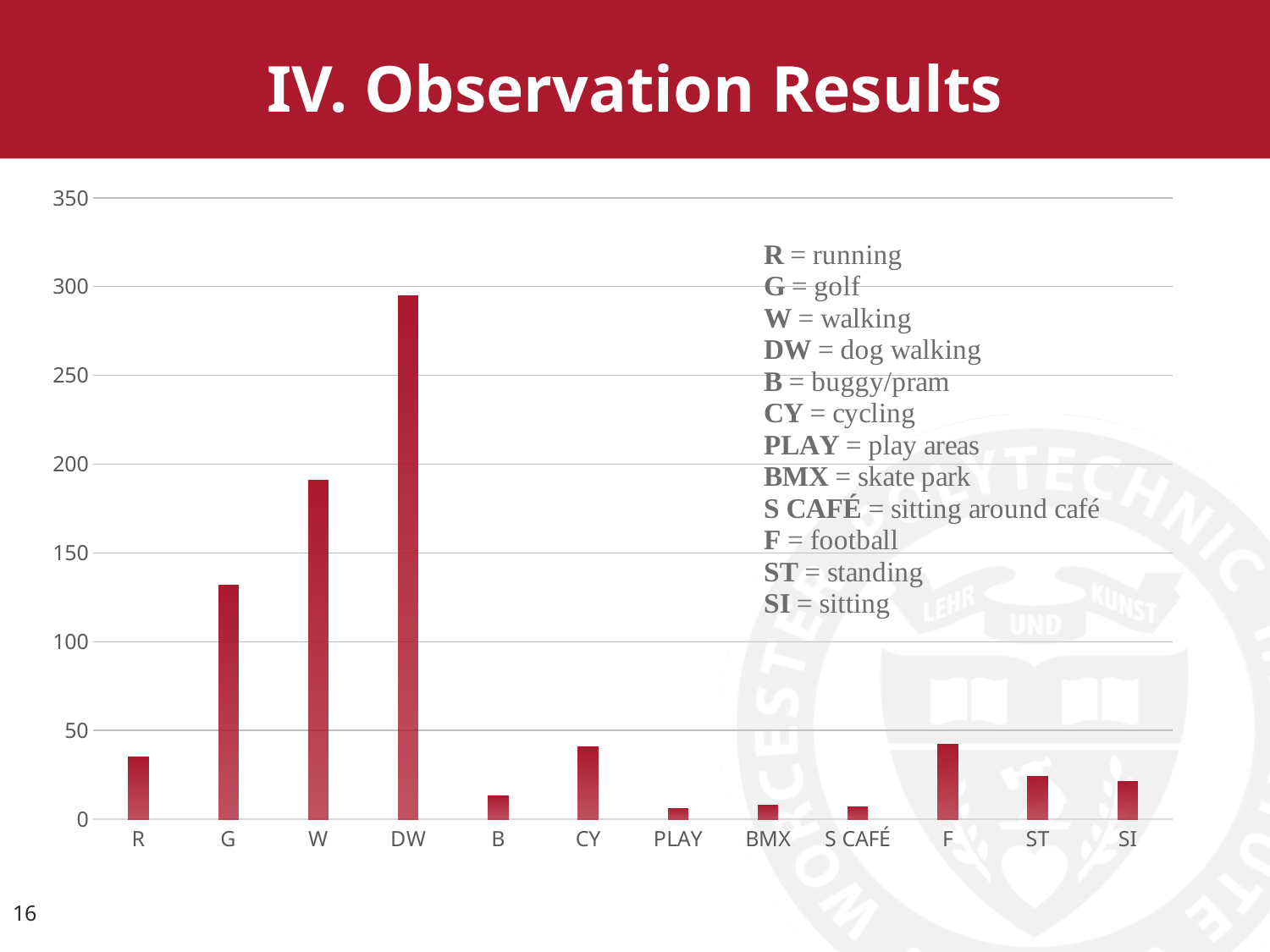
Which has the larger value, G or W? W According to the key on the slide, what does the category DW stand for? dog walking Is the value for G greater or less than 100? greater Is the value for R greater or less than 50? less How many categories are shown on the x axis of the chart? 12 Is the value for W greater or less than 150? greater Which has the larger value, R or G? G Which category has the highest bar in the chart? DW What kind of chart is shown on the slide? bar chart Which has the larger value, B or CY? CY